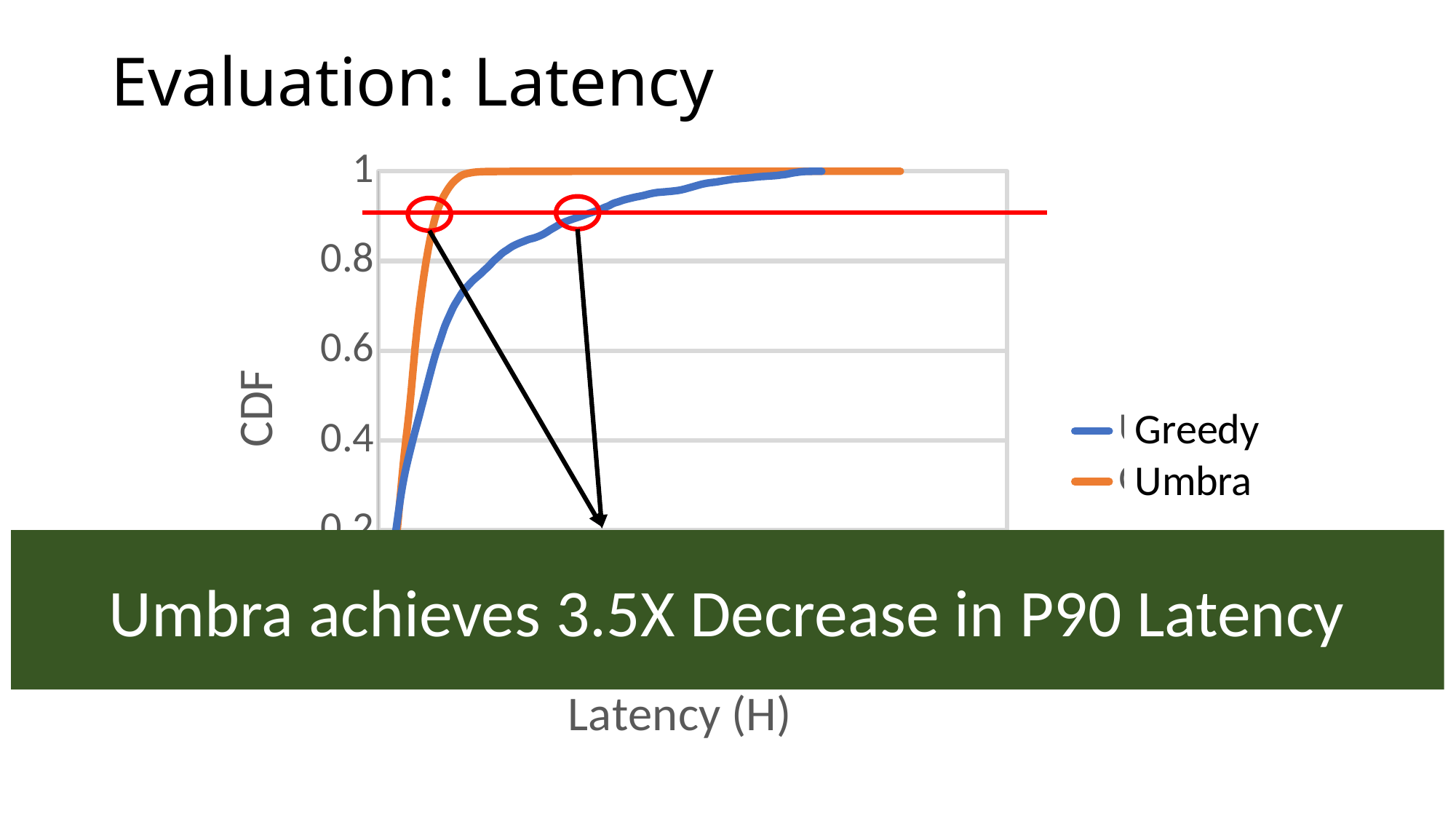
According to the slide, by what factor does Umbra decrease P90 latency compared to Greedy? 3.5X How many series does the legend list? 2 What are the two series named in the legend? Greedy and Umbra What is the lowest y-axis tick value visible on the chart? 0.2 What is the label of the y axis? CDF Do the CDF curves rise or fall as latency increases along the x axis? rise Which series has the higher CDF value at the latency where Umbra first reaches 1? Umbra What is the highest value shown on the y axis? 1 What kind of chart is shown on the slide? line chart Which series crosses the red horizontal line at CDF 0.9 at a lower latency? Umbra Which series reaches a CDF of 1 at a lower latency, Greedy or Umbra? Umbra